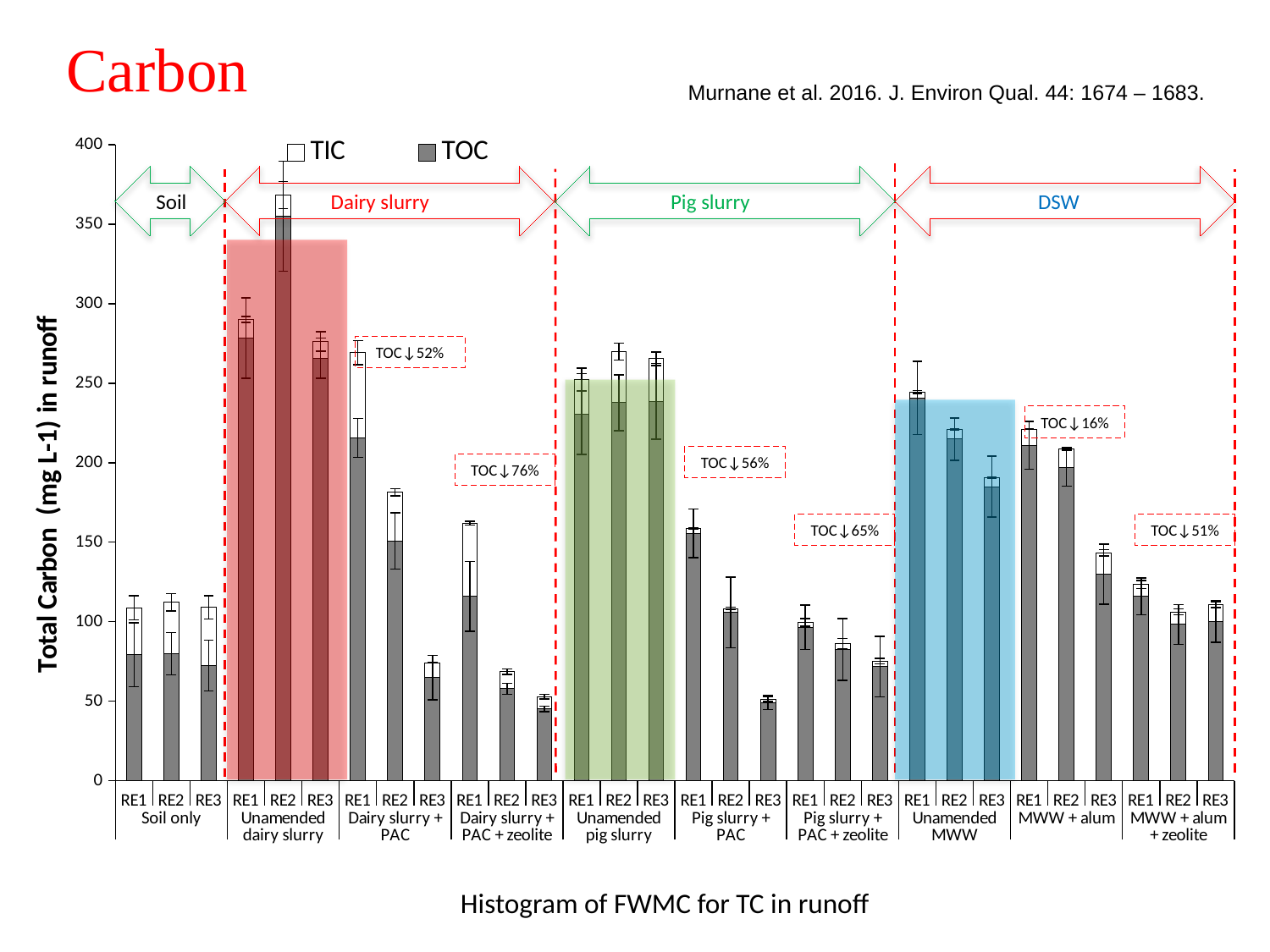
What is the caption printed below the chart? Histogram of FWMC for TC in runoff How many treatment groups are shown along the x axis of the chart? 10 According to the annotation on the chart, by what percentage did TOC decrease for the Dairy slurry + PAC treatment? 52% What are the two series named in the chart legend? TIC and TOC How many series does the chart legend list? 2 Which has a larger total carbon value: Unamended dairy slurry RE1 or Soil only RE1? Unamended dairy slurry RE1 What kind of chart is shown on the slide? Stacked bar chart Within the Dairy slurry + PAC group, do the total carbon values rise or fall from RE1 to RE3? fall Is the total carbon value for Soil only RE1 greater or less than 150? less Is the total carbon value for Dairy slurry + PAC + zeolite RE3 greater or less than 100? less Which bar has the highest total carbon value in the chart? Unamended dairy slurry RE2 Is the total carbon value for Unamended pig slurry RE1 greater or less than 200? greater